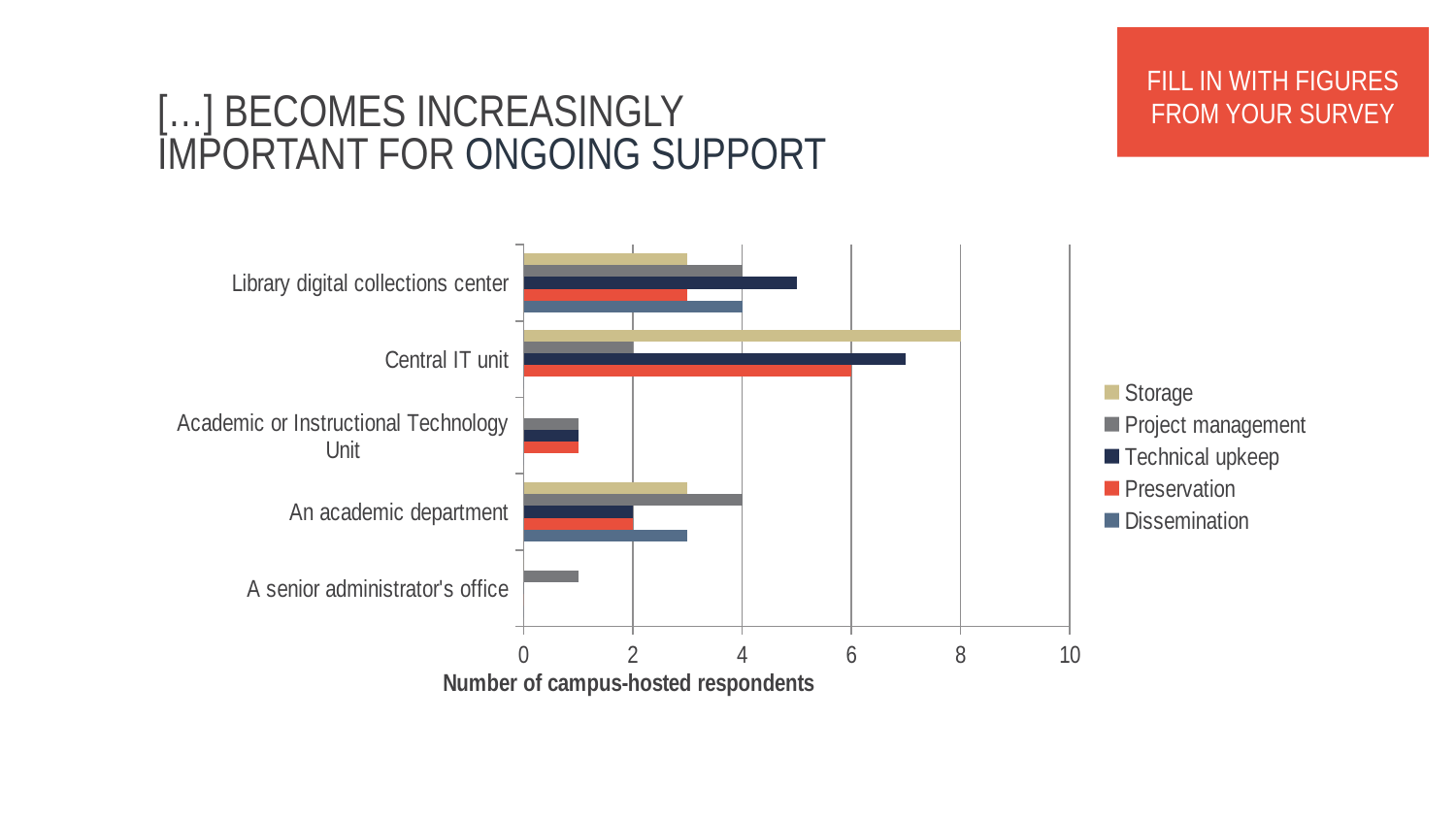
How many series does the legend list? 5 What is the Project management value for An academic department? 4 Is the Technical upkeep value for Central IT unit greater or less than 6? greater How many categories are shown on the vertical axis? 5 What kind of chart is shown on the slide? bar chart What is the Preservation value for Central IT unit? 6 What is the Project management value for Library digital collections center? 4 What is the difference between the Storage value and the Preservation value for Central IT unit? 2 Which is larger for Central IT unit: the Storage value or the Project management value? Storage What is the Storage value for Central IT unit? 8 Which category has the highest Storage value? Central IT unit Is the Technical upkeep value for Library digital collections center greater or less than 4? greater